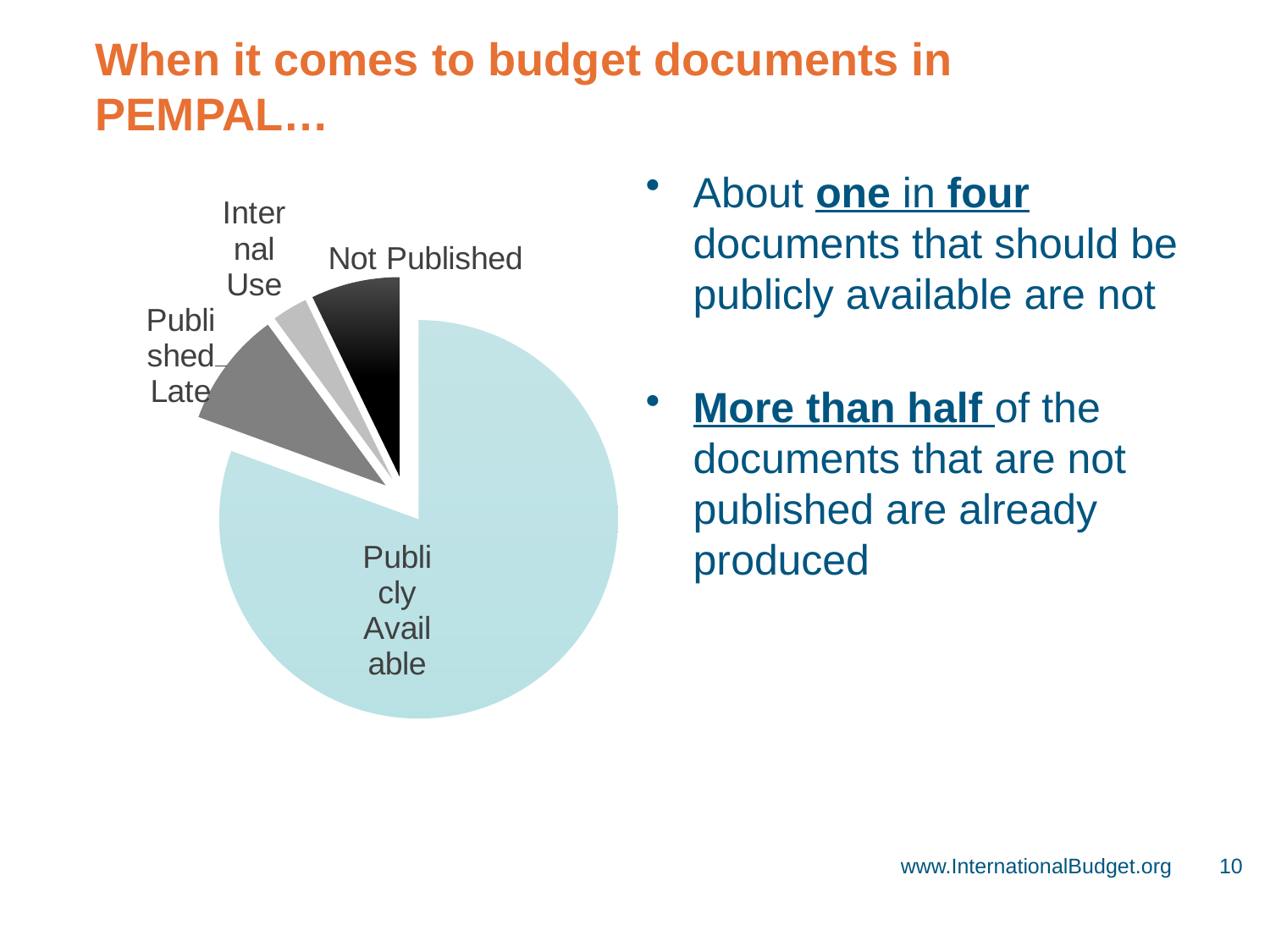
What kind of chart is shown on the slide? pie chart Which slice is larger, Not Published or Internal Use? Not Published What colour is the Not Published slice of the pie chart? black Which slice is larger, Published Late or Internal Use? Published Late Which category has the largest slice in the pie chart? Publicly Available Which slice is larger, Publicly Available or Not Published? Publicly Available What colour is the Publicly Available slice of the pie chart? light blue How many slices does the pie chart have? 4 Which category has the smallest slice in the pie chart? Internal Use